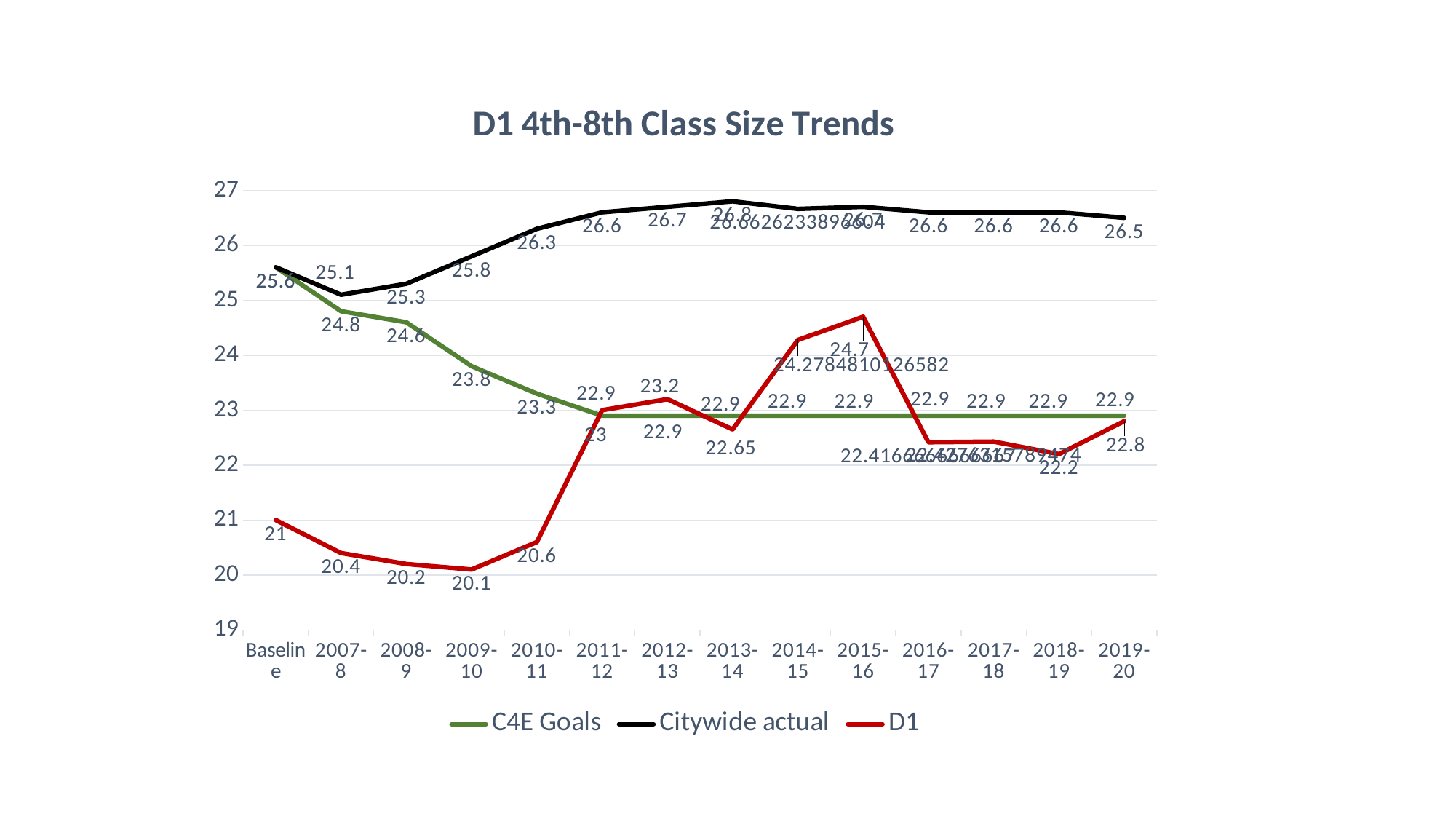
What is the D1 value for 2009-10? 20.1 How many series does the legend list? 3 Is the D1 value for 2014-15 greater or less than 24? greater What is the C4E Goals value for 2010-11? 23.3 Which is larger in 2007-8, the Citywide actual value or the C4E Goals value? Citywide actual What type of chart is shown on the slide? Line chart How many categories are shown on the x axis? 14 What is the Citywide actual value for 2012-13? 26.7 What is the difference between the Citywide actual value and the D1 value for 2019-20? 3.7 In which year does the D1 series reach its lowest value? 2009-10 In which year does the D1 series reach its highest value? 2015-16 Does the C4E Goals series rise or fall from Baseline to 2011-12? Fall